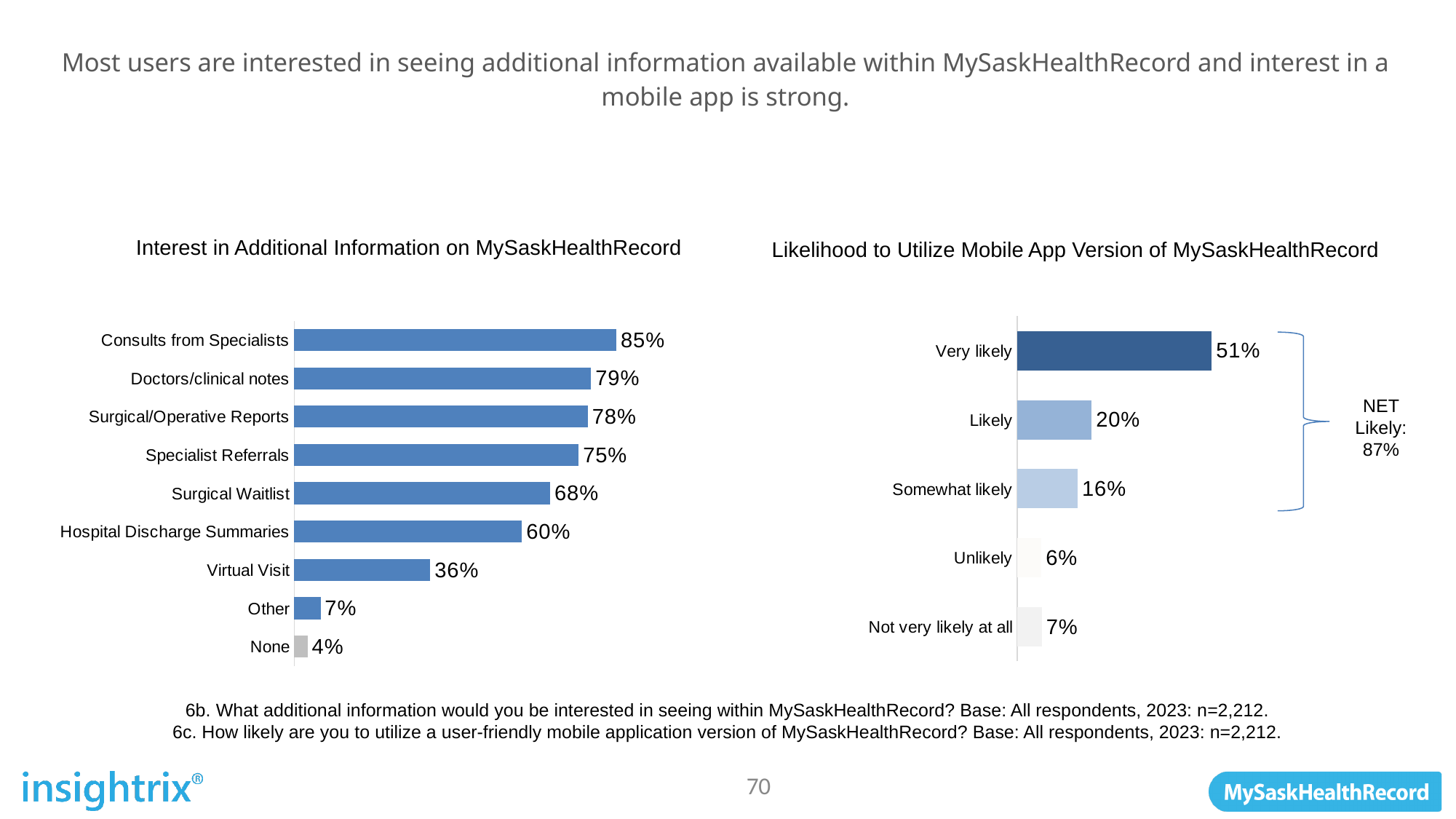
In the 'Likelihood to Utilize Mobile App Version of MySaskHealthRecord' chart, what NET Likely percentage is shown? 87% In the 'Likelihood to Utilize Mobile App Version of MySaskHealthRecord' chart, what is the value for Very likely? 51% In the 'Interest in Additional Information on MySaskHealthRecord' chart, which category has the lowest value? None In the 'Likelihood to Utilize Mobile App Version of MySaskHealthRecord' chart, which category has the highest value? Very likely In the 'Interest in Additional Information on MySaskHealthRecord' chart, which is larger: Surgical Waitlist or Specialist Referrals? Specialist Referrals What type of chart is the 'Likelihood to Utilize Mobile App Version of MySaskHealthRecord' chart? Bar chart In the 'Likelihood to Utilize Mobile App Version of MySaskHealthRecord' chart, what is the value for Somewhat likely? 16% In the 'Interest in Additional Information on MySaskHealthRecord' chart, how many categories are shown? 9 In the 'Interest in Additional Information on MySaskHealthRecord' chart, what is the value for Virtual Visit? 36% In the 'Likelihood to Utilize Mobile App Version of MySaskHealthRecord' chart, what is the difference between Likely and Unlikely? 14% In the 'Interest in Additional Information on MySaskHealthRecord' chart, what is the difference between Doctors/clinical notes and Hospital Discharge Summaries? 19% In the 'Interest in Additional Information on MySaskHealthRecord' chart, what is the value for Consults from Specialists? 85%